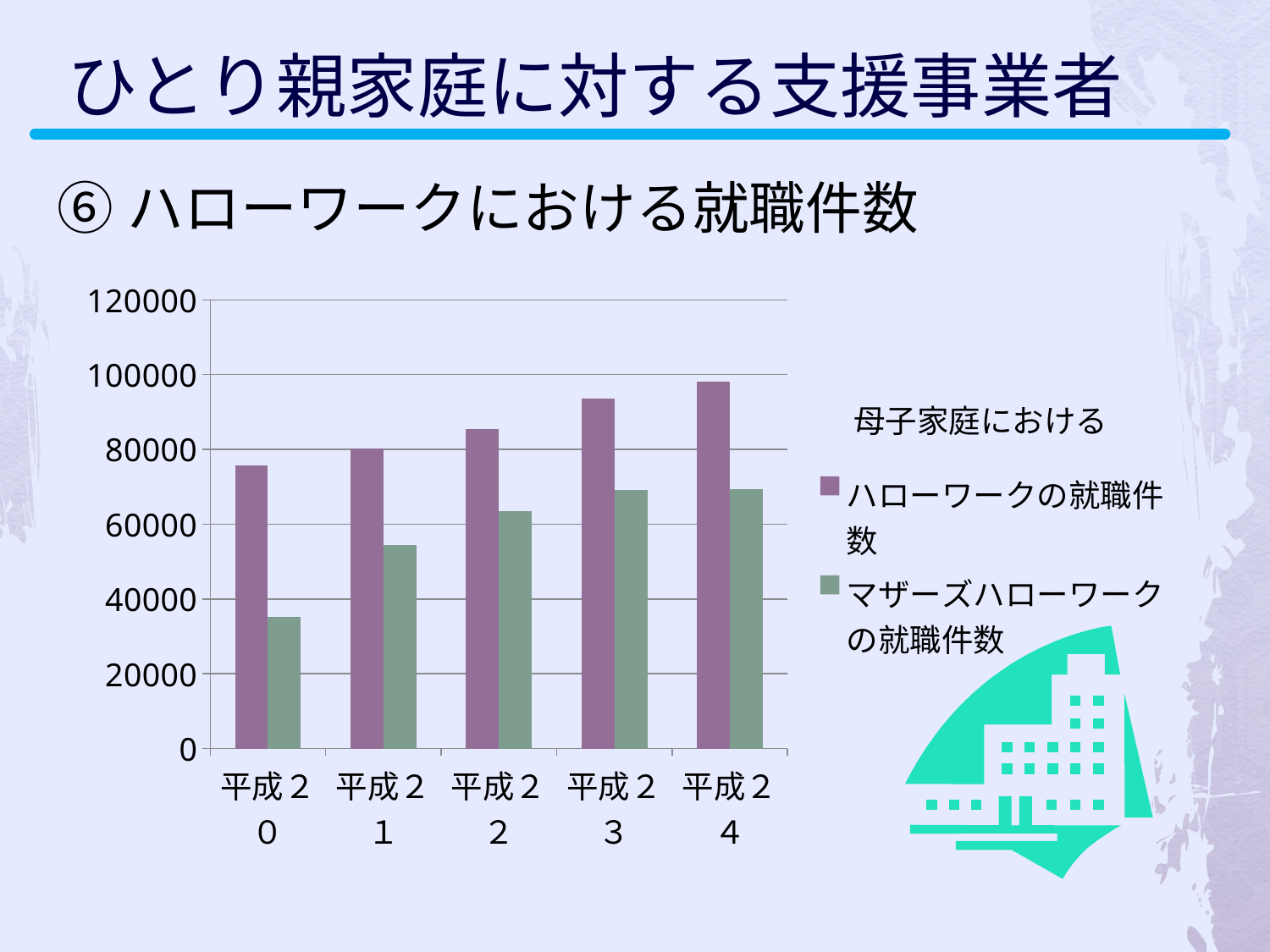
In which year is ハローワークの就職件数 highest? 平成24 What kind of chart is shown on the slide? bar chart Is the value of ハローワークの就職件数 for 平成20 greater or less than 80000? less Do the values of ハローワークの就職件数 rise or fall from 平成20 to 平成24? rise How many year categories are shown on the x axis? 5 How many series does the legend list? 2 Is the value of マザーズハローワークの就職件数 for 平成21 greater or less than 60000? less Is the value of マザーズハローワークの就職件数 for 平成23 greater or less than 60000? greater For 平成20, which is larger: ハローワークの就職件数 or マザーズハローワークの就職件数? ハローワークの就職件数 In which year is マザーズハローワークの就職件数 lowest? 平成20